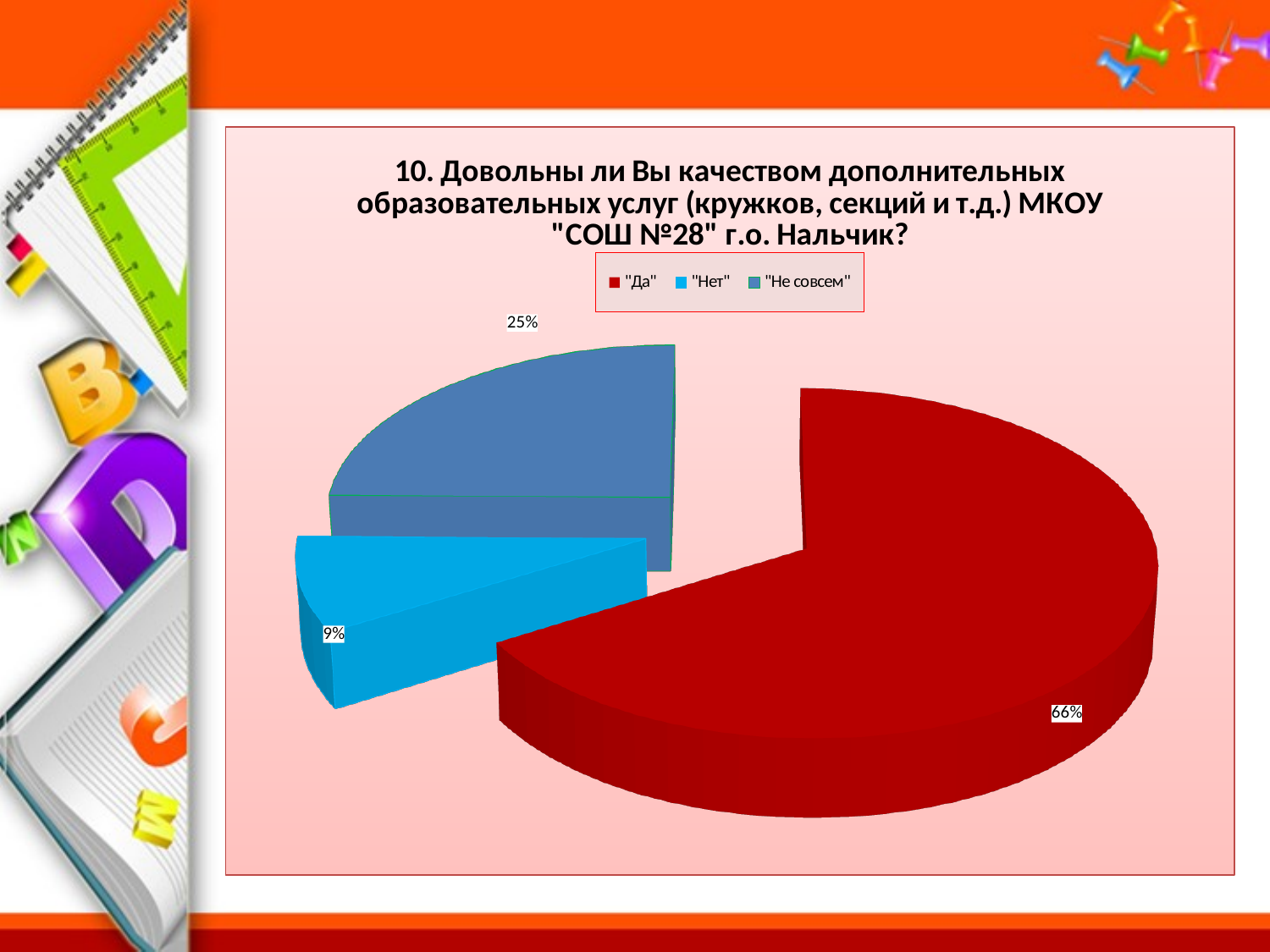
What colour is the slice for "Нет"? light blue What percentage of respondents answered "Не совсем"? 25% What colour is the slice for "Да"? red What percentage of respondents answered "Нет"? 9% Which answer has the smallest share of the pie? "Нет" What type of chart is shown on the slide? pie chart Which is larger: the share for "Нет" or the share for "Не совсем"? "Не совсем" What is the difference in percentage points between "Да" and "Не совсем"? 41 How many slices does the pie chart have? 3 Which answer has the largest share of the pie? "Да" What percentage of respondents answered "Да"? 66% How many entries does the legend list? 3